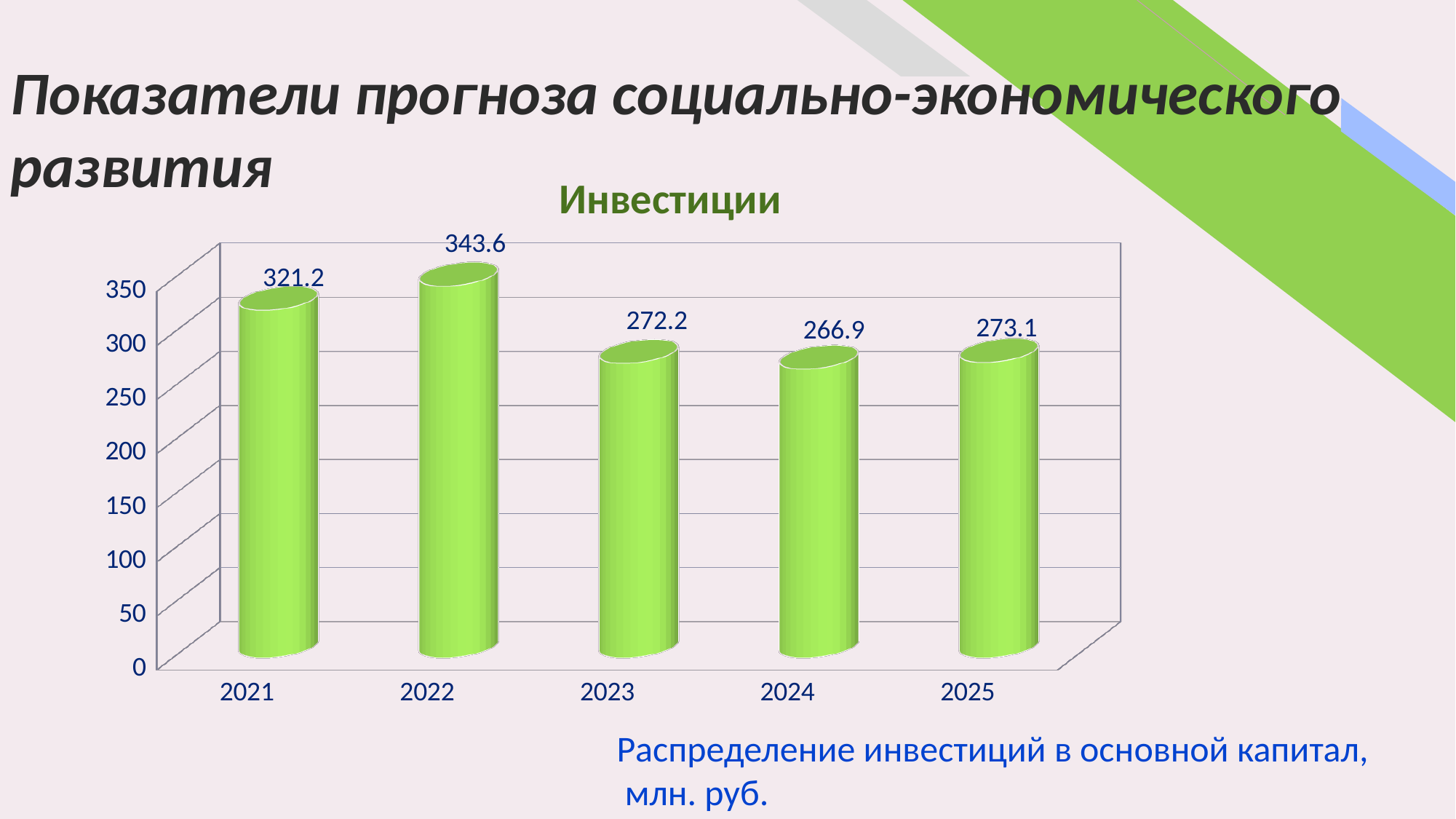
Which year has the highest value in the Инвестиции chart? 2022 Is the value for 2023 in the Инвестиции chart greater or less than 300? less Which year has the lowest value in the Инвестиции chart? 2024 How many years are shown on the x axis of the Инвестиции chart? 5 What is the value for 2024 in the Инвестиции chart? 266.9 Which is larger in the Инвестиции chart: the value for 2021 or the value for 2025? 2021 What is the title of the chart on the slide? Инвестиции What is the value for 2021 in the Инвестиции chart? 321.2 What kind of chart is the Инвестиции chart? bar chart What is the difference between the values for 2022 and 2021 in the Инвестиции chart? 22.4 What is the value for 2022 in the Инвестиции chart? 343.6 What is the difference between the values for 2023 and 2024 in the Инвестиции chart? 5.3